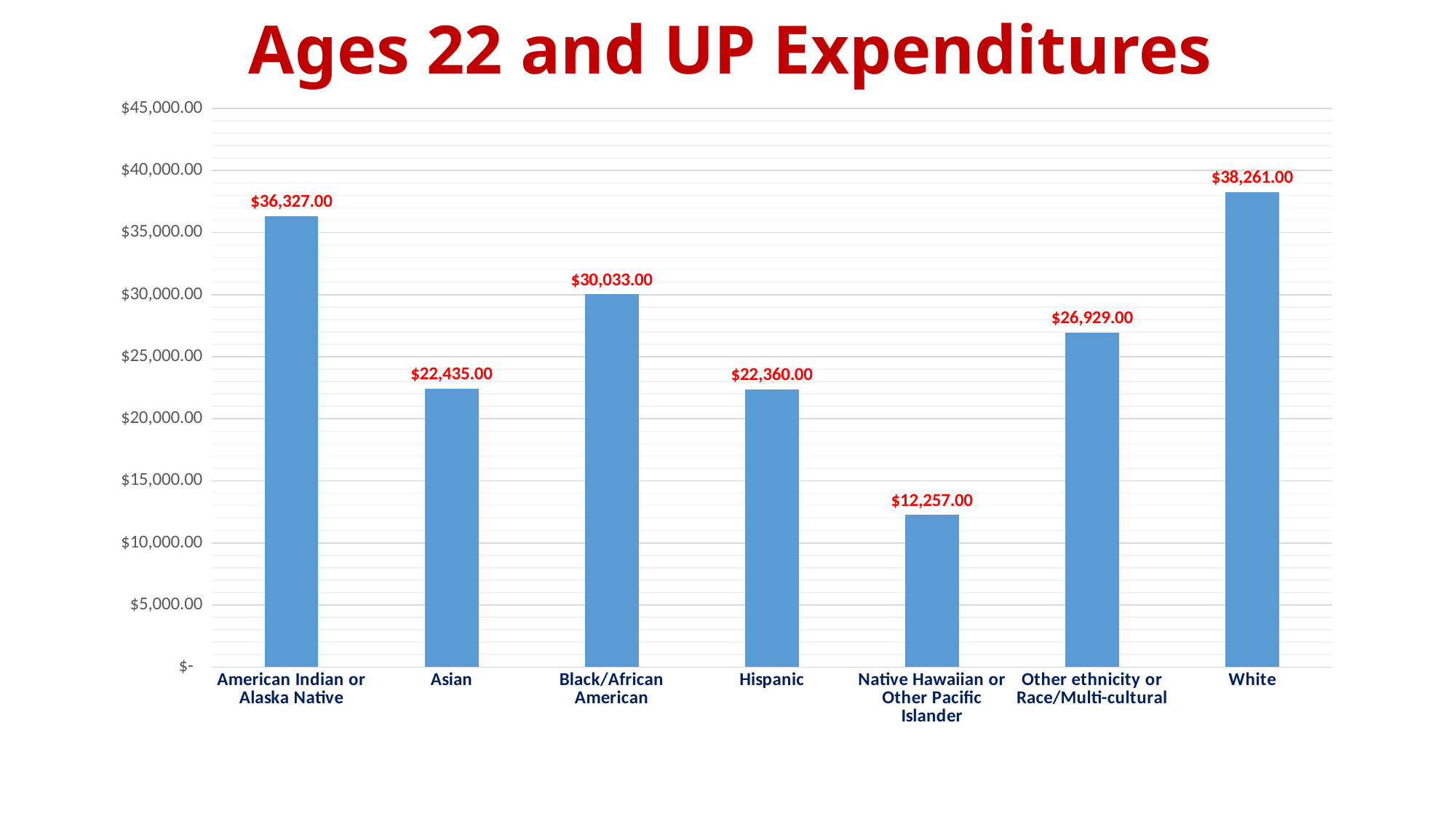
What is the difference between the expenditure for White and for American Indian or Alaska Native? $1,934.00 Which category has the lowest expenditure? Native Hawaiian or Other Pacific Islander Which has a larger expenditure, Black/African American or Other ethnicity or Race/Multi-cultural? Black/African American How many categories are shown on the chart? 7 Which category has the highest expenditure? White What is the difference between the expenditure for Asian and for Hispanic? $75.00 What is the expenditure value for Black/African American? $30,033.00 Is the expenditure for Other ethnicity or Race/Multi-cultural greater or less than $25,000.00? greater What is the expenditure value for Native Hawaiian or Other Pacific Islander? $12,257.00 What kind of chart is shown on the slide? Bar chart What is the expenditure value for White? $38,261.00 What is the title of the chart? Ages 22 and UP Expenditures